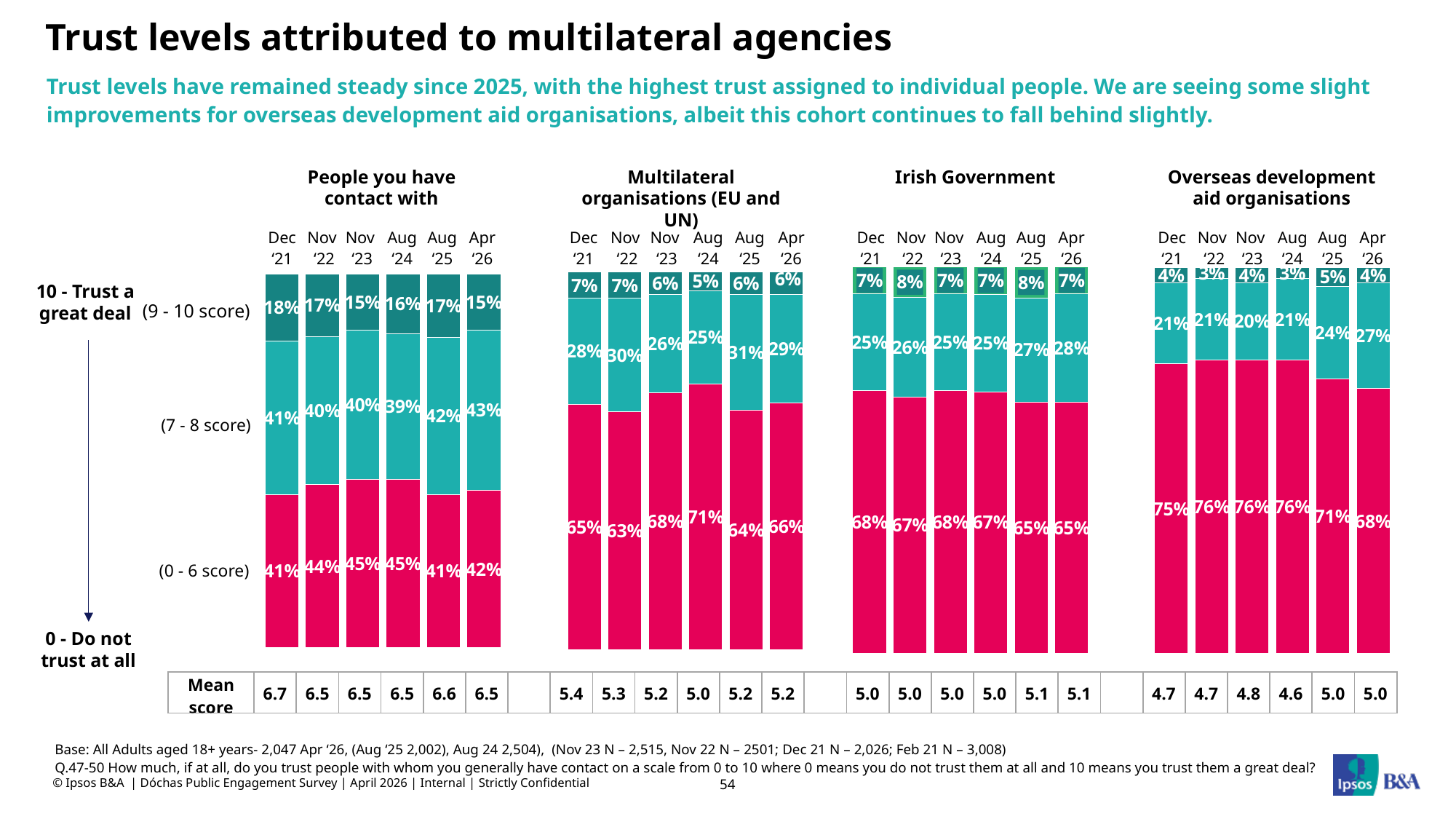
In the 'People you have contact with' chart, which period has the highest mean score? Dec '21 In the 'Overseas development aid organisations' chart, what is the difference between the 7-8 score share in Apr '26 and in Dec '21? 6 percentage points How many charts are shown on the slide? 4 In the 'Irish Government' chart, what percentage gave a 7-8 score in Apr '26? 28% In the 'Overseas development aid organisations' chart, what percentage gave a 0-6 score in Apr '26? 68% In the 'Overseas development aid organisations' chart, does the 0-6 score share rise or fall from Aug '24 to Apr '26? Fall In the 'Multilateral organisations (EU and UN)' chart, which period has the highest share of 0-6 scores? Aug '24 What type of chart is used to show the trust levels? Stacked bar chart In the 'People you have contact with' chart, what percentage gave a 9-10 score in Dec '21? 18% How many time periods are shown in each chart? 6 In the 'Irish Government' chart, is the 0-6 score share larger in Dec '21 or in Apr '26? Dec '21 In the 'Multilateral organisations (EU and UN)' chart, what is the mean score for Aug '24? 5.0